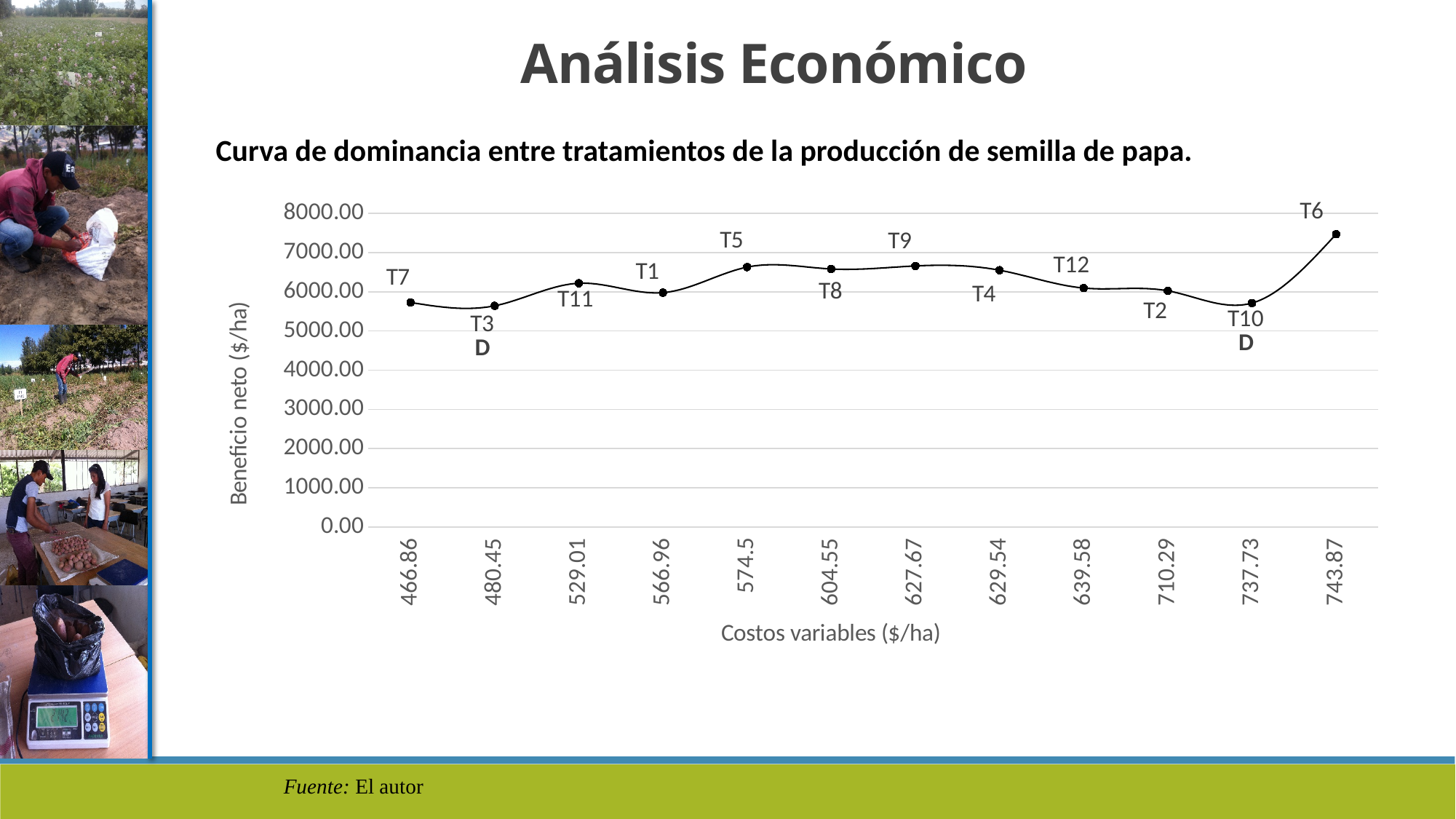
Which treatment has the highest net benefit (Beneficio neto)? T6 What is the variable cost (Costos variables) value on the x axis for treatment T6? 743.87 Is the net benefit for T3 greater or less than 6000.00? less Which has a higher net benefit, T1 or T9? T9 How many treatment points are plotted on the chart? 12 What kind of chart is shown on the slide? line chart What is the variable cost (Costos variables) value on the x axis for treatment T7? 466.86 Which treatment is plotted at the variable cost of 574.5? T5 Is the net benefit for T6 greater or less than 7000.00? greater Which has a higher net benefit, T5 or T3? T5 Is the net benefit for T9 greater or less than 6000.00? greater What is the title of the y axis? Beneficio neto ($/ha)